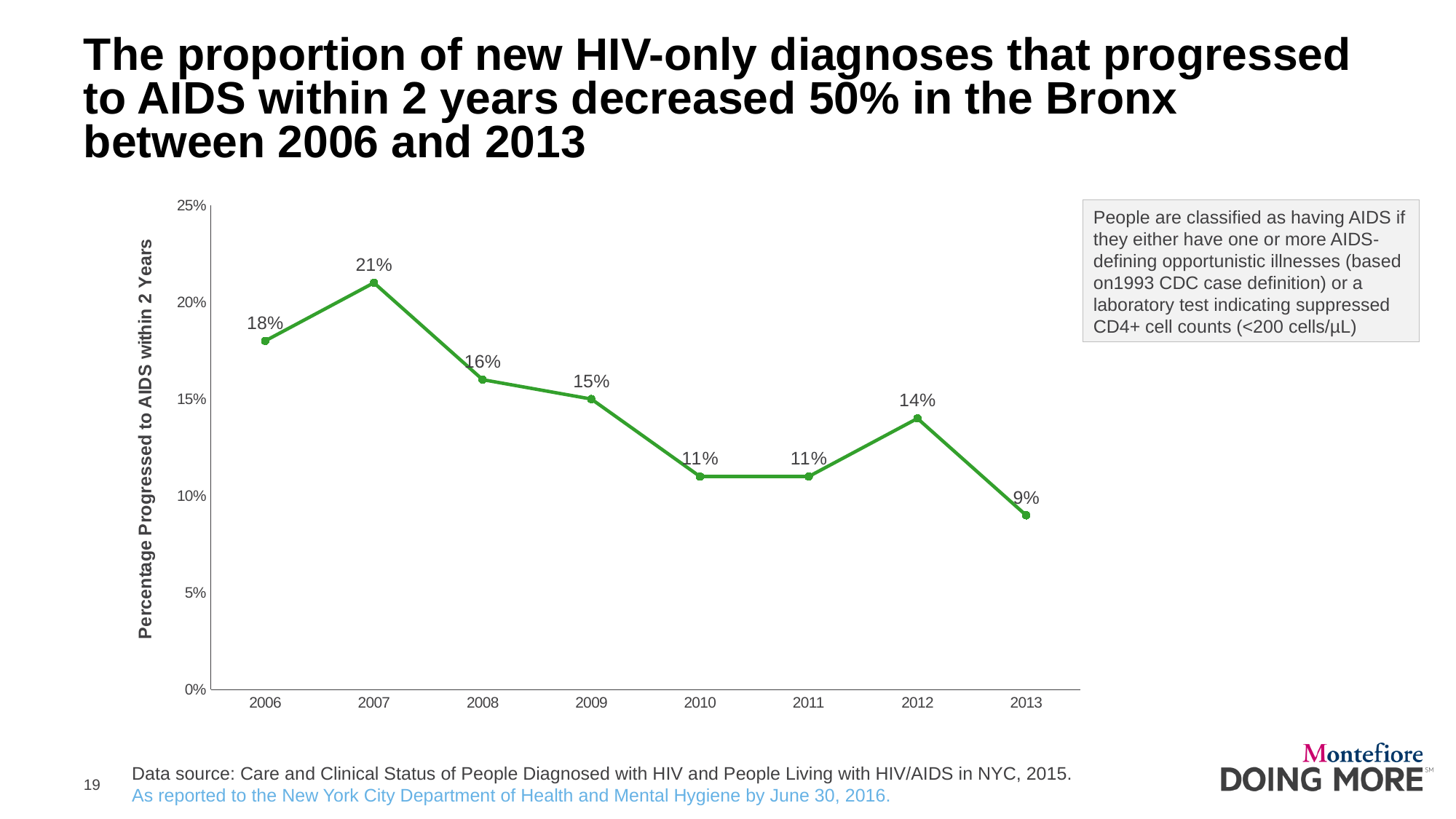
Which year has the lowest percentage progressed to AIDS within 2 years? 2013 Which two years share the same value of 11%? 2010 and 2011 Which year has a higher value, 2008 or 2012? 2008 What is the value plotted for 2012? 14% How many years are plotted on the x axis? 8 What is the difference between the 2007 value and the 2013 value? 12% What is the label on the y axis of the chart? Percentage Progressed to AIDS within 2 Years Overall, do the values rise or fall from 2006 to 2013? Fall What is the value plotted for 2013? 9% Which year has the highest percentage progressed to AIDS within 2 years? 2007 What kind of chart is shown on the slide? Line chart What percentage of new HIV-only diagnoses progressed to AIDS within 2 years in 2006? 18%